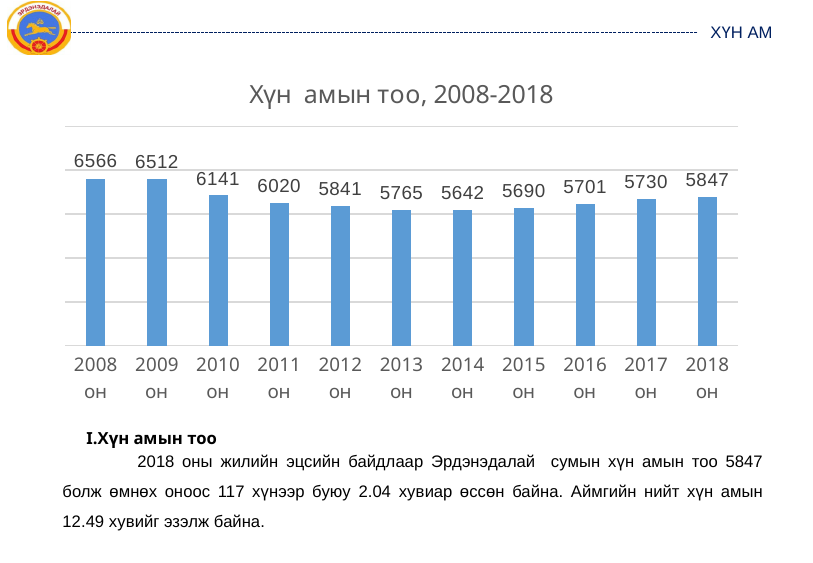
What is the value for 2008 он? 6566 How many years are shown on the chart? 11 Which is larger, the value for 2010 он or the value for 2011 он? 2010 он Which year has the lowest value? 2014 он What is the value for 2018 он? 5847 What is the difference between the values for 2008 он and 2018 он? 719 What is the title of the chart? Хүн амын тоо, 2008-2018 Which year has the highest value? 2008 он Do the values rise or fall from 2008 он to 2014 он? fall What is the value for 2013 он? 5765 What kind of chart is this? bar chart What is the difference between the values for 2017 он and 2018 он? 117